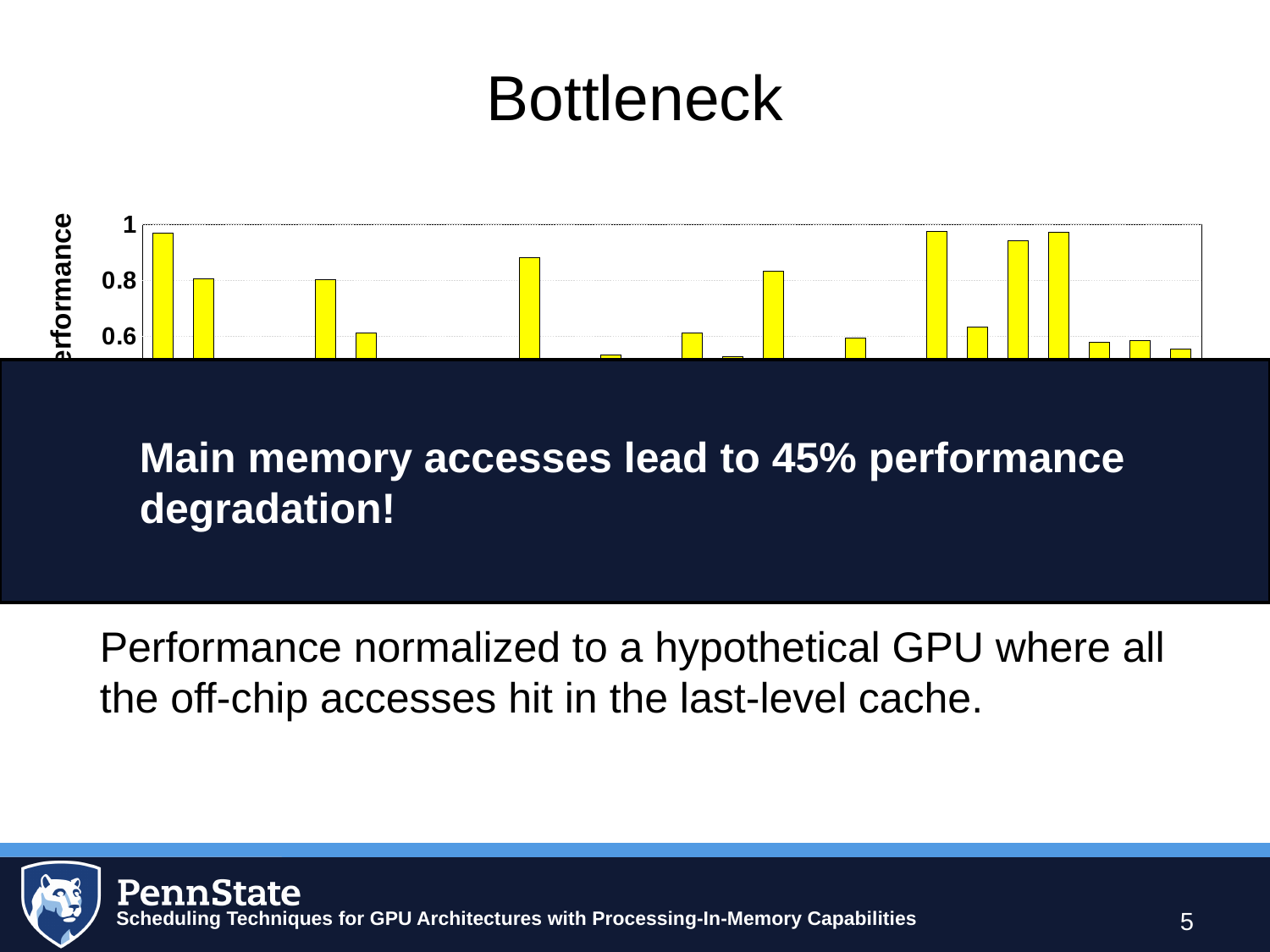
Is the value of the rightmost bar in the chart greater or less than 0.6? less Is the value of the leftmost bar in the chart greater or less than 0.8? greater Do any bars in the chart exceed the y-axis value of 1? No What colour are the bars in the chart? yellow What is the highest tick value shown on the y axis of the chart? 1 What kind of chart is shown on the slide? bar chart